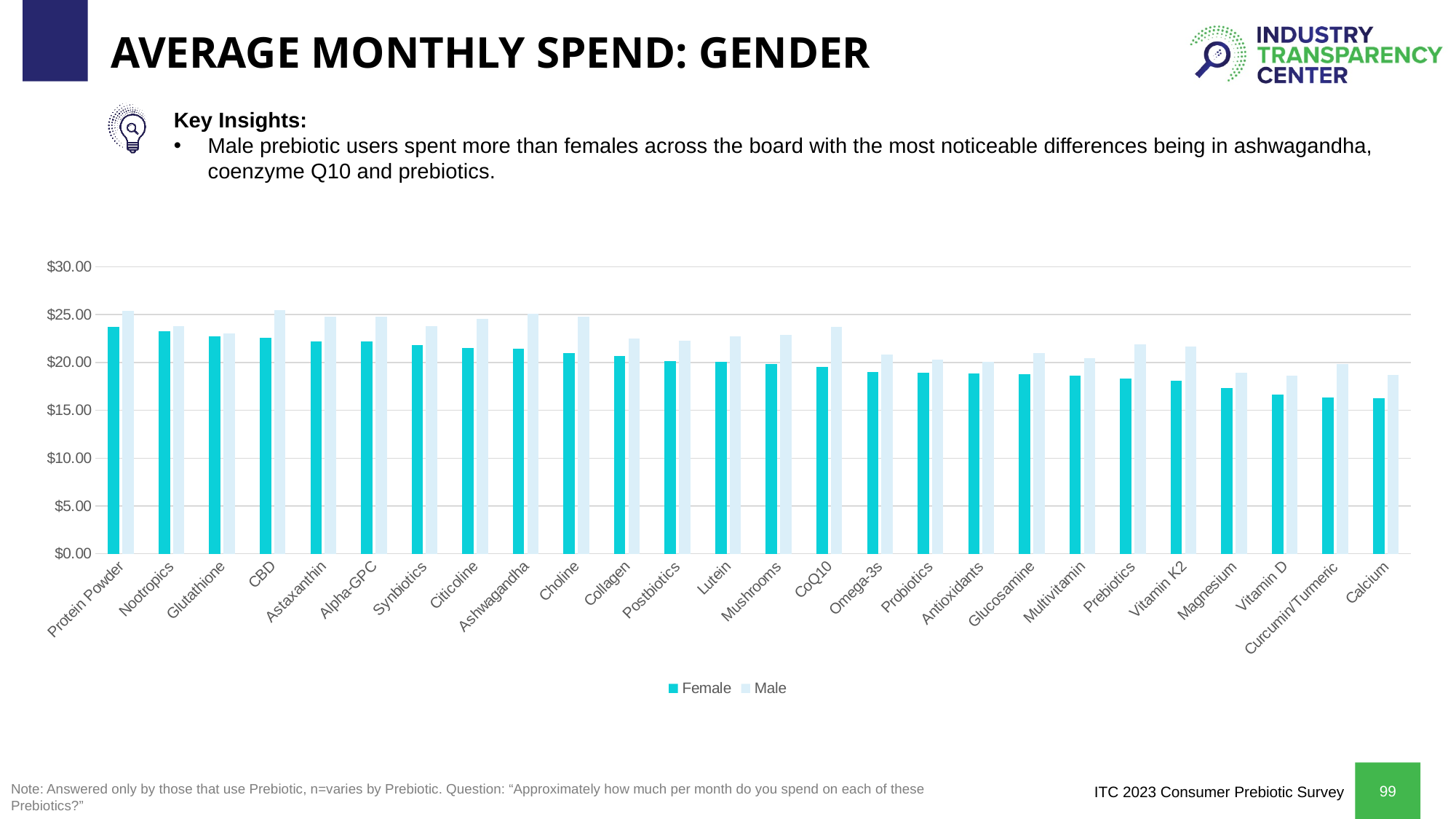
Which category has the highest Female value? Protein Powder Is the Female value for Protein Powder greater or less than $20.00? greater Is the Female value for Vitamin D greater or less than $20.00? less Which is larger, the Female value for Protein Powder or the Female value for Calcium? Protein Powder For Ashwagandha, which is larger, the Female value or the Male value? Male Is the Male value for Vitamin D greater or less than $20.00? less What are the two series named in the legend? Female and Male Do the Female values rise or fall moving from left to right along the x axis? Fall What kind of chart is shown on the slide? Bar chart How many series does the legend list? 2 How many categories are shown on the x axis? 26